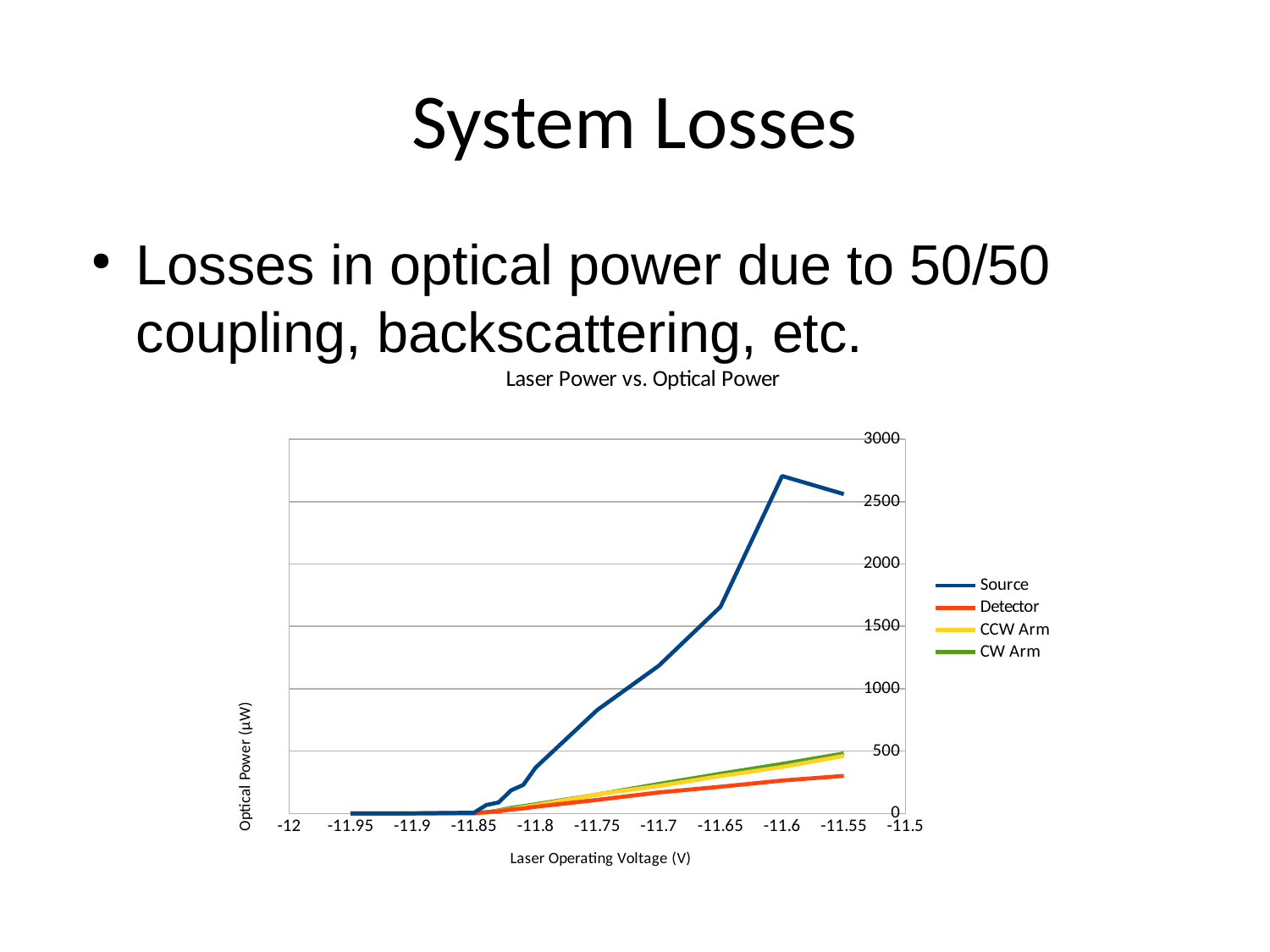
Which series reaches the highest optical power on the chart? Source At -11.6 V, which series has the larger optical power, Source or Detector? Source Is the value of the Source series at -11.65 V greater or less than 1500? greater How many series does the legend list? 4 Does the Detector series rise or fall as the voltage goes from -11.85 V to -11.55 V? rise Is the value of the Source series at -11.75 V greater or less than 1000? less Which series has the lowest optical power at -11.55 V? Detector Is the value of the Source series at -11.6 V greater or less than 2500? greater What is the title of the chart? Laser Power vs. Optical Power What is the label of the y axis? Optical Power (µW) What kind of chart is shown on the slide? line chart